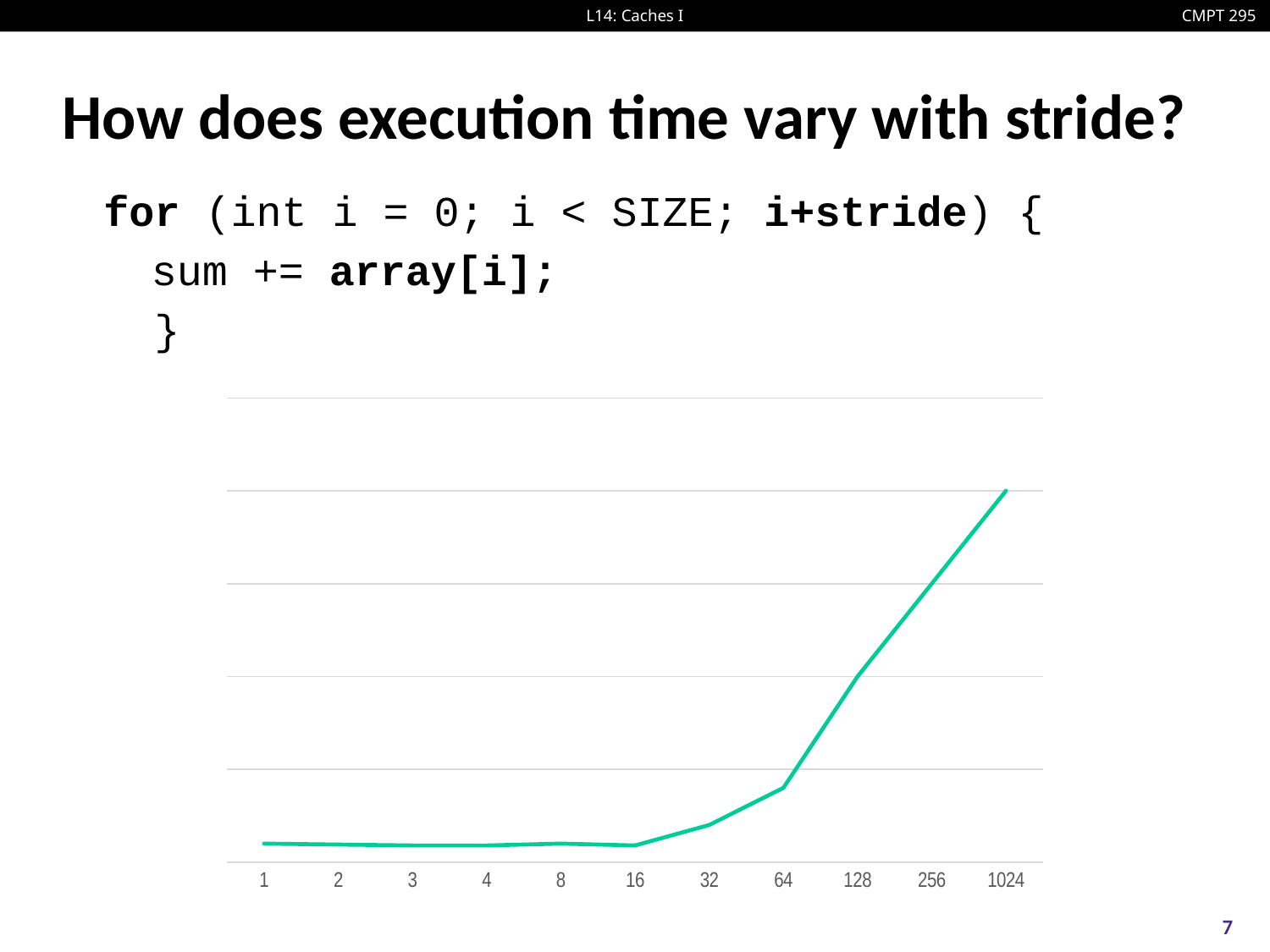
Between which two consecutive x-axis labels does the line show its steepest rise? 64 and 128 Which has the larger plotted value, stride 256 or stride 16? 256 At which stride value does the line reach its highest point? 1024 Which has the larger plotted value, stride 1024 or stride 64? 1024 Does the plotted line rise or fall as stride increases from 64 to 1024? rise What is the last stride value labelled on the x axis? 1024 Which has the larger plotted value, stride 128 or stride 32? 128 What is the first stride value labelled on the x axis? 1 What kind of chart is shown on the slide? line chart How many stride values are plotted along the x axis of the chart? 11